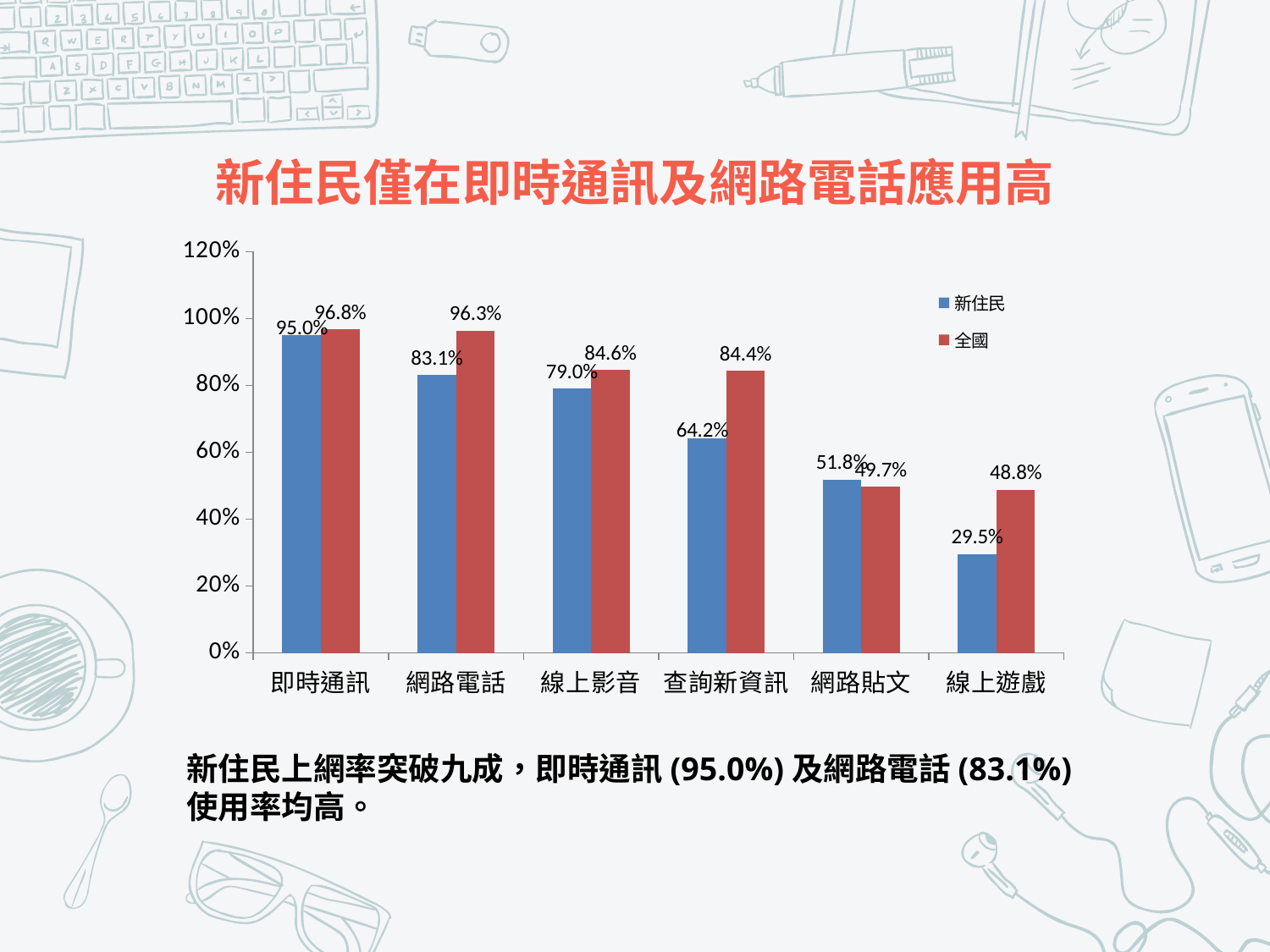
What is the 全國 value for 查詢新資訊? 84.4% For 網路貼文, which series has the larger value, 新住民 or 全國? 新住民 Is the 全國 value for 線上遊戲 greater or less than 40%? greater Which category has the lowest 新住民 value? 線上遊戲 What is the 新住民 value for 線上遊戲? 29.5% What is the difference between the 全國 and 新住民 values for 查詢新資訊? 20.2% What is the 新住民 value for 網路電話? 83.1% How many series does the legend list? 2 How many categories are shown on the x axis? 6 What kind of chart is shown on the slide? bar chart Which colour represents the 全國 series in the chart? red Which category has the highest 全國 value? 即時通訊